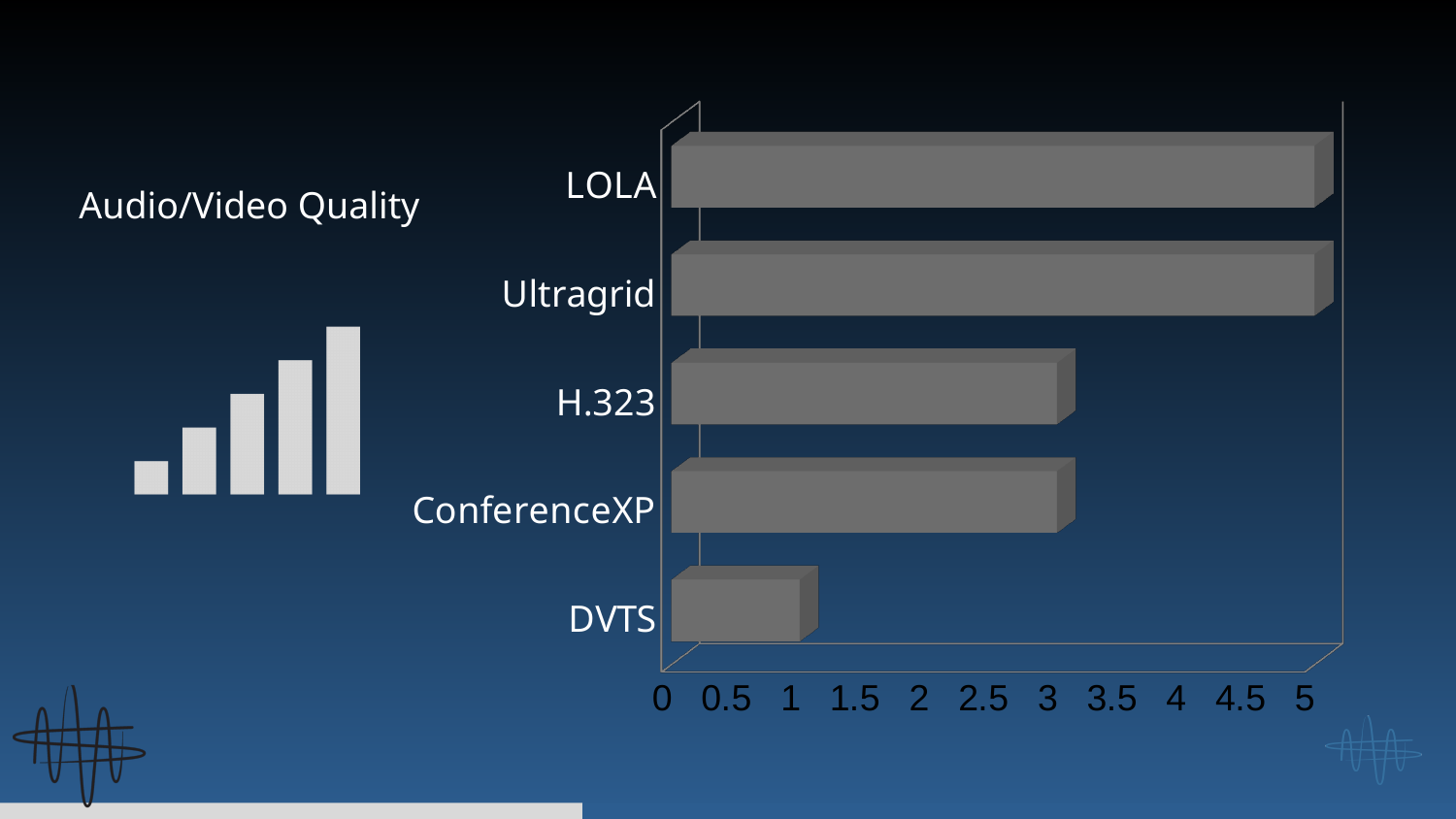
Which category has the lowest value in the chart? DVTS Is the value for H.323 greater or less than 2? greater Is the value for ConferenceXP greater or less than 4? less Is the value for LOLA greater or less than 4? greater Which has the larger value, LOLA or DVTS? LOLA How many categories are plotted in the chart? 5 What kind of chart is shown on the slide? bar chart Which has the larger value, H.323 or DVTS? H.323 What is the title text shown next to the chart? Audio/Video Quality